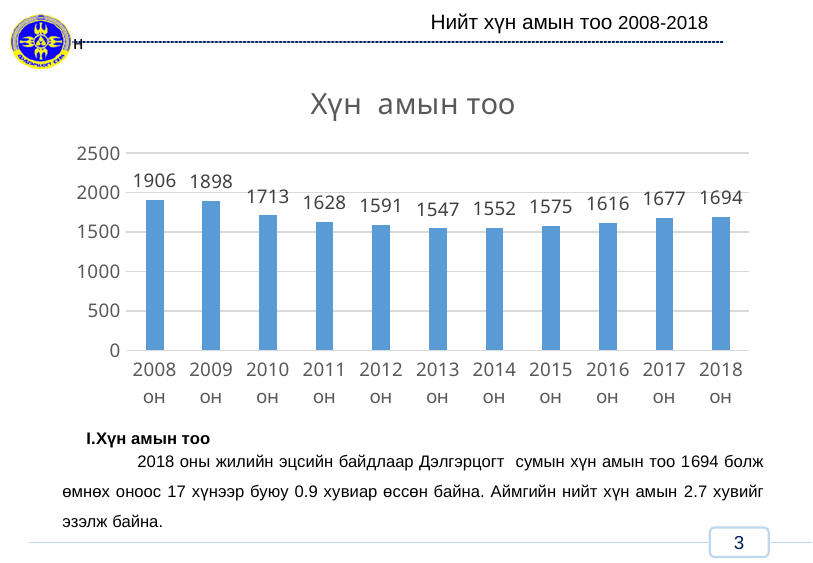
What is the value for 2013 он? 1547 Which year has the lowest value? 2013 он What kind of chart is shown on the slide? bar chart What is the value for 2008 он? 1906 What is the value for 2018 он? 1694 What is the title of the chart? Хүн амын тоо Is the value for 2012 он greater or less than 2000? less Which is larger, the value for 2010 он or the value for 2016 он? 2010 он What is the difference between the values for 2018 он and 2017 он? 17 How many years are shown on the x axis? 11 What is the difference between the values for 2008 он and 2009 он? 8 Which year has the highest value? 2008 он